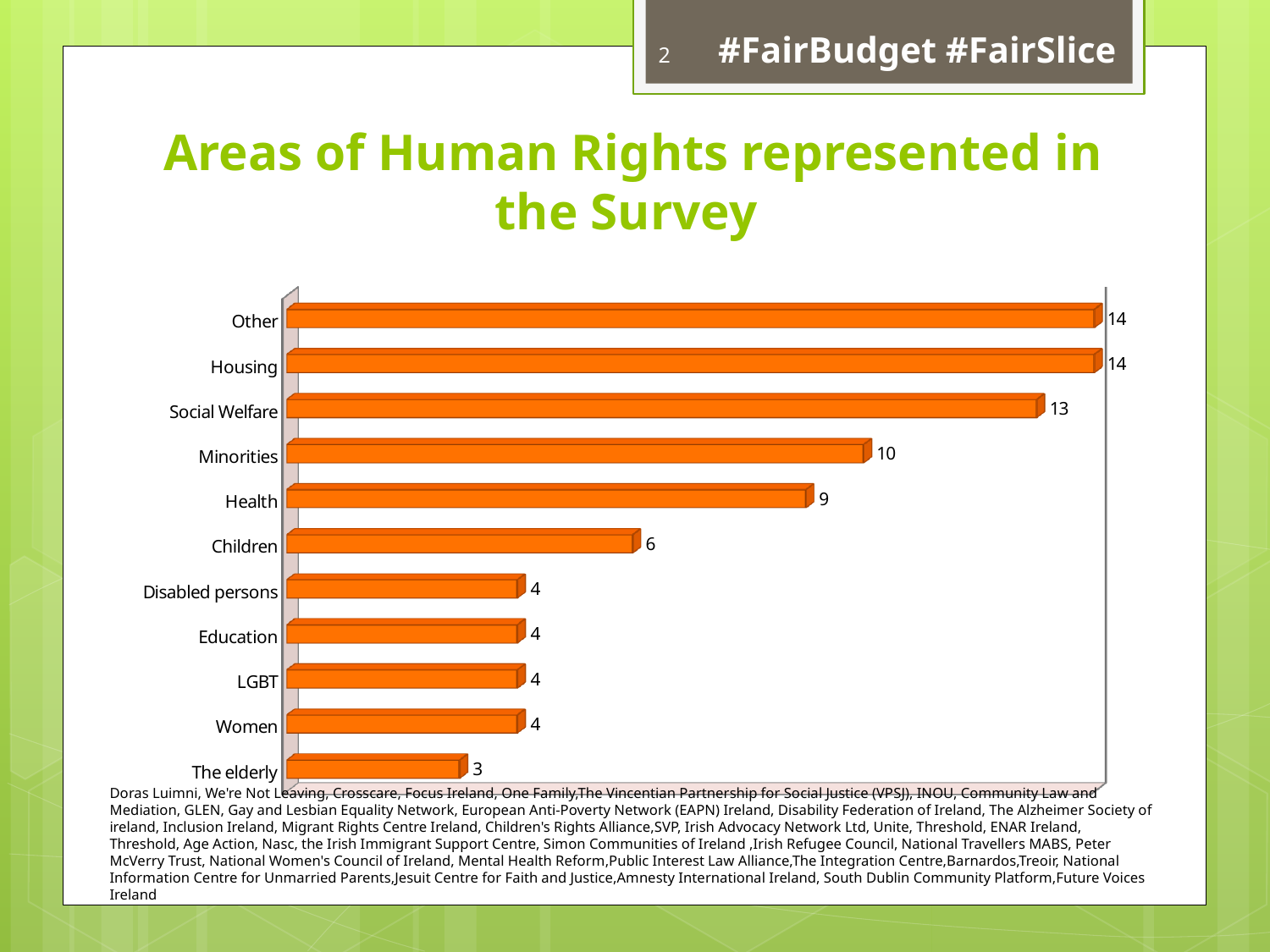
How many categories are shown in the chart? 11 What is the value for Minorities? 10 What kind of chart is shown on the slide? Bar chart What is the difference between the values for Housing and Social Welfare? 1 What is the title of the chart on the slide? Areas of Human Rights represented in the Survey What is the difference between the values for Minorities and Children? 4 What is the value for Children? 6 What is the value for Social Welfare? 13 Which is larger, the value for Women or the value for The elderly? Women Which category has the lowest value? The elderly What is the value for Health? 9 Which is larger, the value for Health or the value for Children? Health